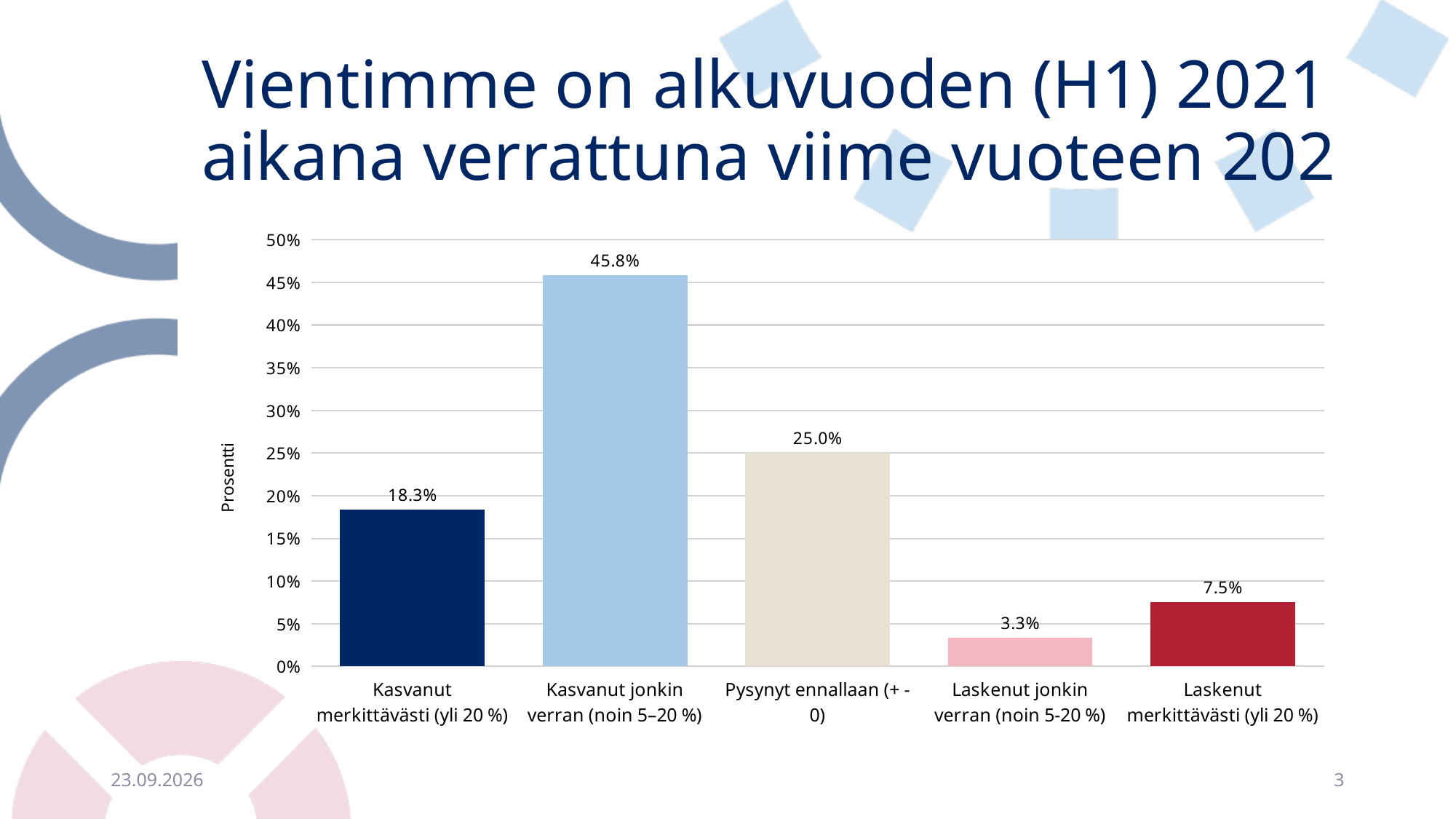
Which category has the highest value? Kasvanut jonkin verran (noin 5–20 %) What is the value for "Laskenut jonkin verran (noin 5-20 %)"? 3.3% What kind of chart is shown on the slide? bar chart What is the difference between the values for "Kasvanut jonkin verran (noin 5–20 %)" and "Pysynyt ennallaan (+ - 0)"? 20.8% What is the value for "Kasvanut jonkin verran (noin 5–20 %)"? 45.8% Which category has the lowest value? Laskenut jonkin verran (noin 5-20 %) What is the value for "Pysynyt ennallaan (+ - 0)"? 25.0% What is the difference between the values for "Kasvanut merkittävästi (yli 20 %)" and "Laskenut merkittävästi (yli 20 %)"? 10.8% Which is larger, the value for "Kasvanut merkittävästi (yli 20 %)" or the value for "Laskenut merkittävästi (yli 20 %)"? Kasvanut merkittävästi (yli 20 %) Is the value for "Pysynyt ennallaan (+ - 0)" greater or less than 30%? less How many categories are shown on the x axis? 5 What is the label of the vertical axis? Prosentti